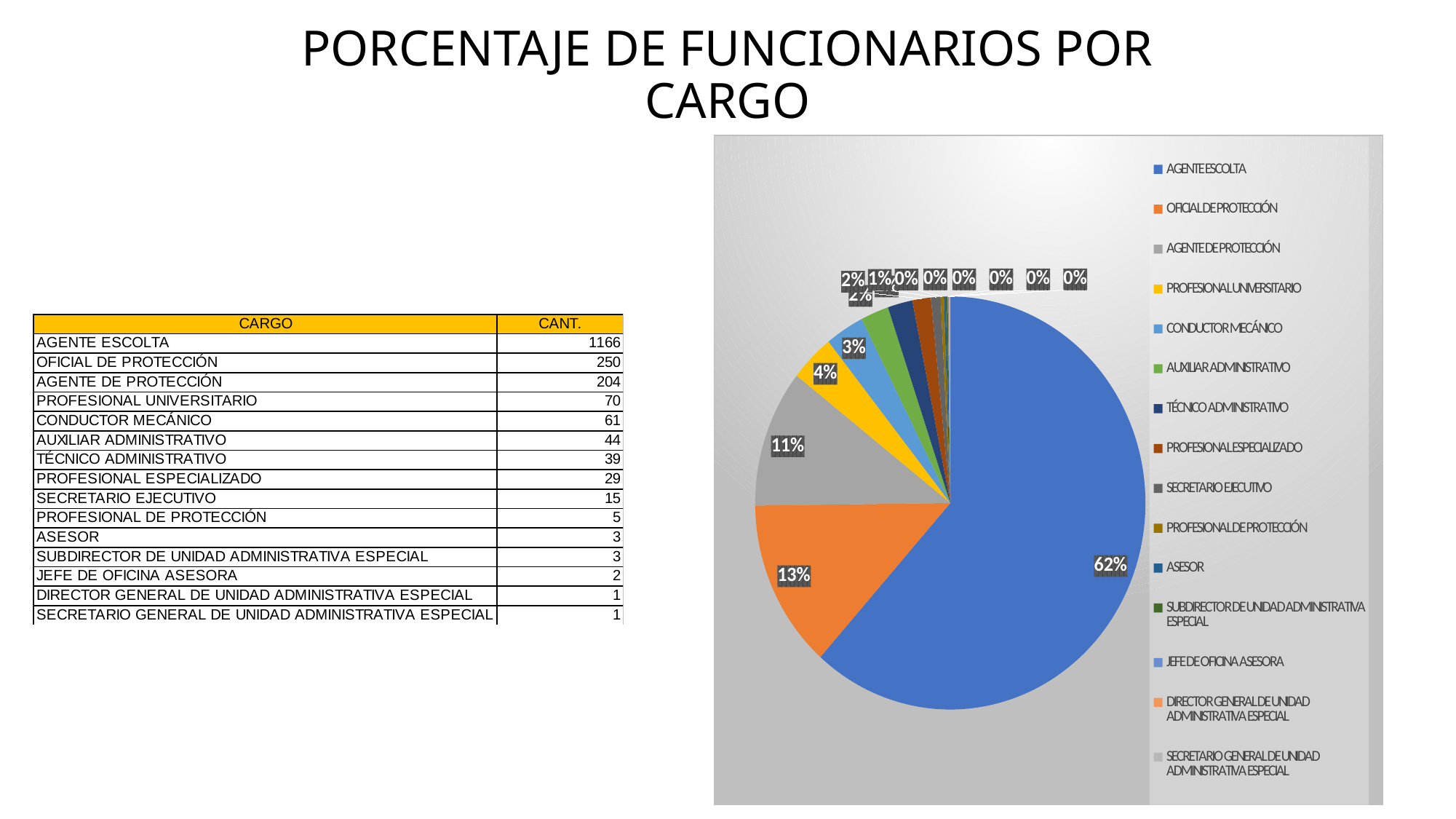
What share of the pie does AGENTE ESCOLTA represent? 62% What share of the pie does CONDUCTOR MECÁNICO represent? 3% What is the difference in percentage points between the AGENTE ESCOLTA slice and the OFICIAL DE PROTECCIÓN slice? 49 percentage points Which slice is larger, OFICIAL DE PROTECCIÓN or AGENTE DE PROTECCIÓN? OFICIAL DE PROTECCIÓN What is the title of the slide containing the pie chart? PORCENTAJE DE FUNCIONARIOS POR CARGO What share of the pie does OFICIAL DE PROTECCIÓN represent? 13% What kind of chart is shown on the slide? pie chart How many categories does the legend of the pie chart list? 15 Which category has the largest slice of the pie? AGENTE ESCOLTA What colour is the AGENTE ESCOLTA slice in the pie chart? blue